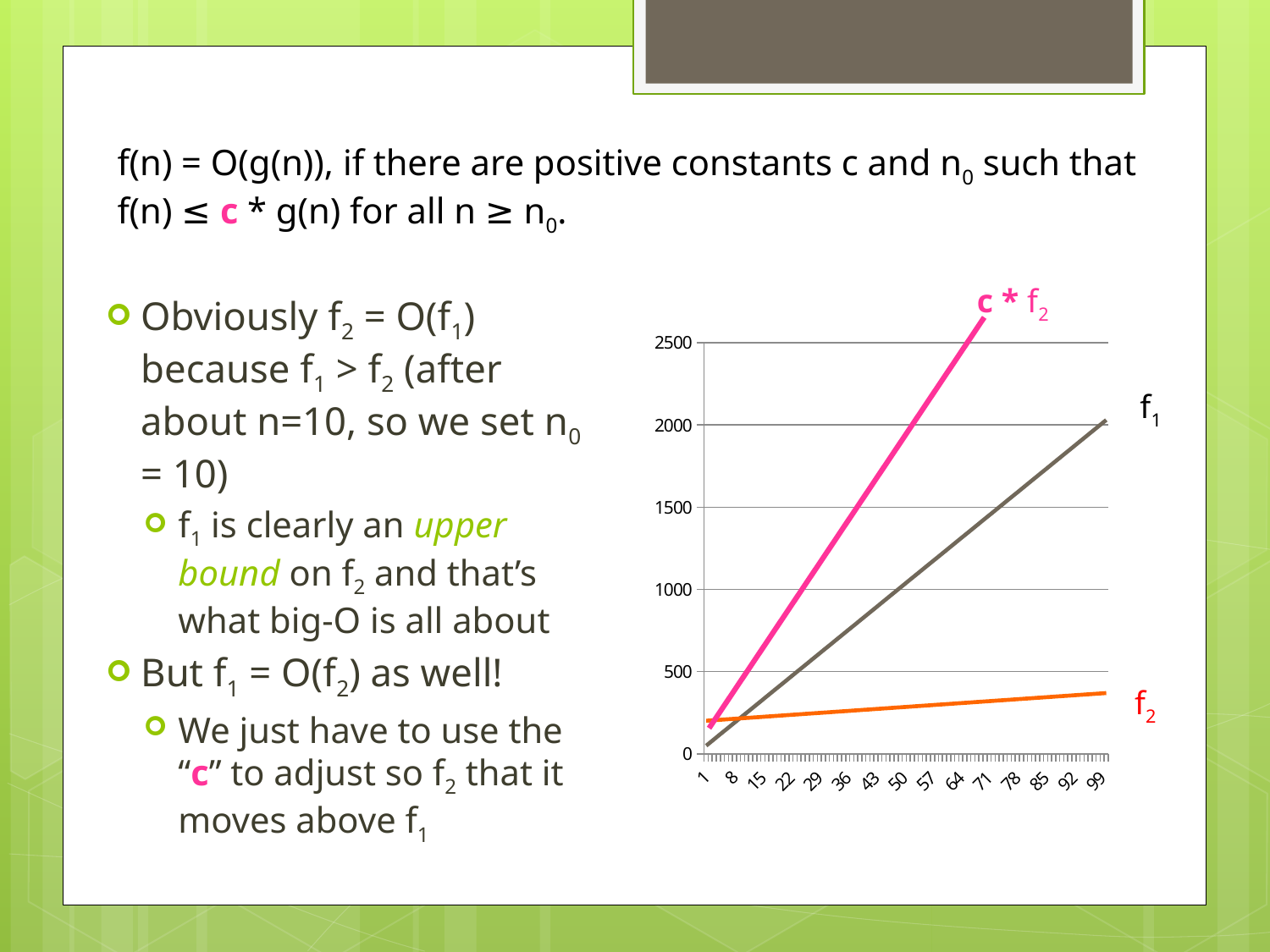
What colour is the f2 line? orange Does the f1 line rise or fall as n increases along the x axis? rise Which line is the lowest at n = 99? f2 Is the value of f1 at n = 29 greater or less than 1000? less At n = 50, which is larger, f1 or c * f2? c * f2 How many lines are plotted on the chart? 3 Does the f2 line rise or fall as n increases along the x axis? rise Is the value of f1 at n = 99 greater or less than 1500? greater Which line is the highest at n = 50? c * f2 What is the highest value labelled on the y axis? 2500 Is the value of f2 at n = 99 greater or less than 500? less What kind of chart is shown on the slide? line chart